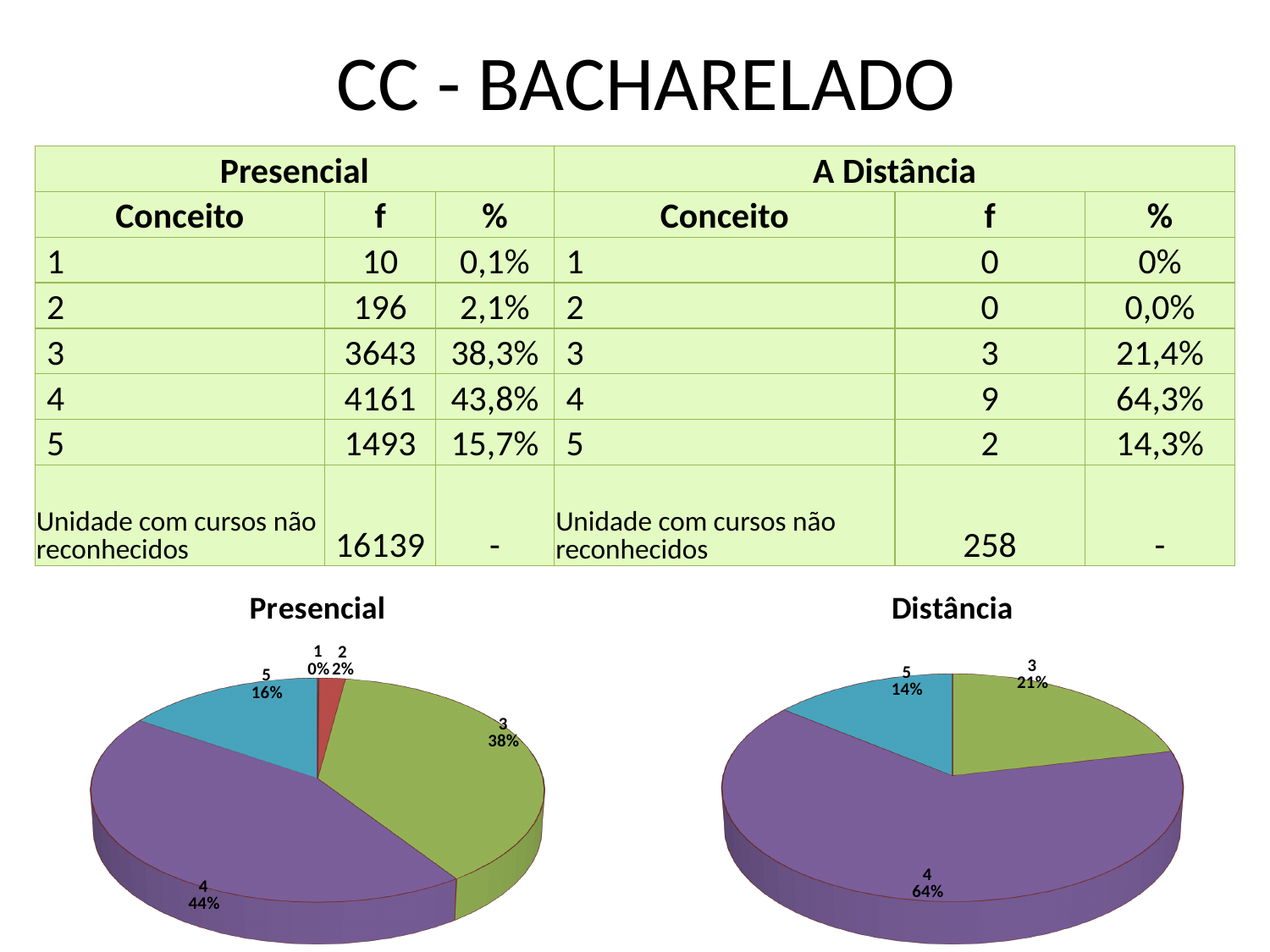
In the "Distância" pie chart, which is larger, the slice for category 3 or the slice for category 5? 3 In the "Presencial" pie chart, which category has the smallest slice? 1 In the "Distância" pie chart, what share is labelled for category 3? 21% In the "Presencial" pie chart, what is the difference between the shares of category 4 and category 3? 6% What kind of chart is the "Presencial" chart? pie chart In the "Presencial" pie chart, which category has the largest slice? 4 In the "Presencial" pie chart, what share is labelled for category 3? 38% In the "Distância" pie chart, which category has the smallest slice? 5 In the "Distância" pie chart, how many slices are labelled? 3 In the "Presencial" pie chart, how many slices are labelled? 5 In the "Distância" pie chart, what share is labelled for category 4? 64% In the "Presencial" pie chart, what share is labelled for category 5? 16%